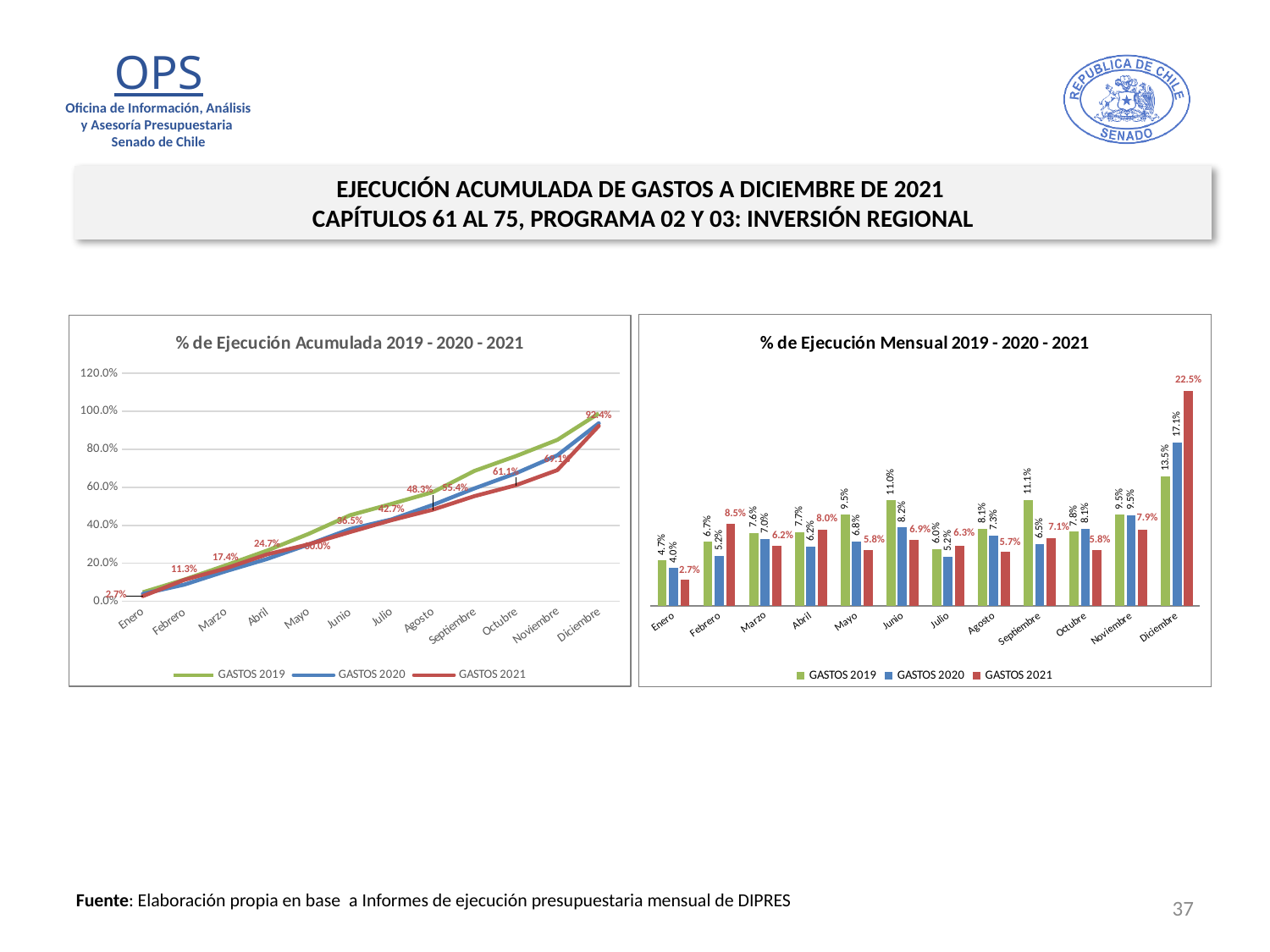
In the right chart '% de Ejecución Mensual 2019 - 2020 - 2021', how many months are shown on the x axis? 12 In the right chart '% de Ejecución Mensual 2019 - 2020 - 2021', which month has the lowest value for GASTOS 2021? Enero In the right chart '% de Ejecución Mensual 2019 - 2020 - 2021', how many series does the legend list? 3 In the left chart '% de Ejecución Acumulada 2019 - 2020 - 2021', what is the value for GASTOS 2021 in Febrero? 11.3% In the right chart '% de Ejecución Mensual 2019 - 2020 - 2021', which is larger in Junio: GASTOS 2019 or GASTOS 2020? GASTOS 2019 In the right chart '% de Ejecución Mensual 2019 - 2020 - 2021', what is the value for GASTOS 2021 in Diciembre? 22.5% In the right chart '% de Ejecución Mensual 2019 - 2020 - 2021', what is the difference between GASTOS 2021 and GASTOS 2020 in Diciembre? 5.4 percentage points What kind of chart is the left chart titled '% de Ejecución Acumulada 2019 - 2020 - 2021'? Line chart In the left chart '% de Ejecución Acumulada 2019 - 2020 - 2021', does the GASTOS 2021 line rise or fall from Enero to Diciembre? Rise What kind of chart is the right chart titled '% de Ejecución Mensual 2019 - 2020 - 2021'? Bar chart In the left chart '% de Ejecución Acumulada 2019 - 2020 - 2021', what is the value for GASTOS 2021 in Julio? 42.7% In the right chart '% de Ejecución Mensual 2019 - 2020 - 2021', which month has the highest value for GASTOS 2021? Diciembre